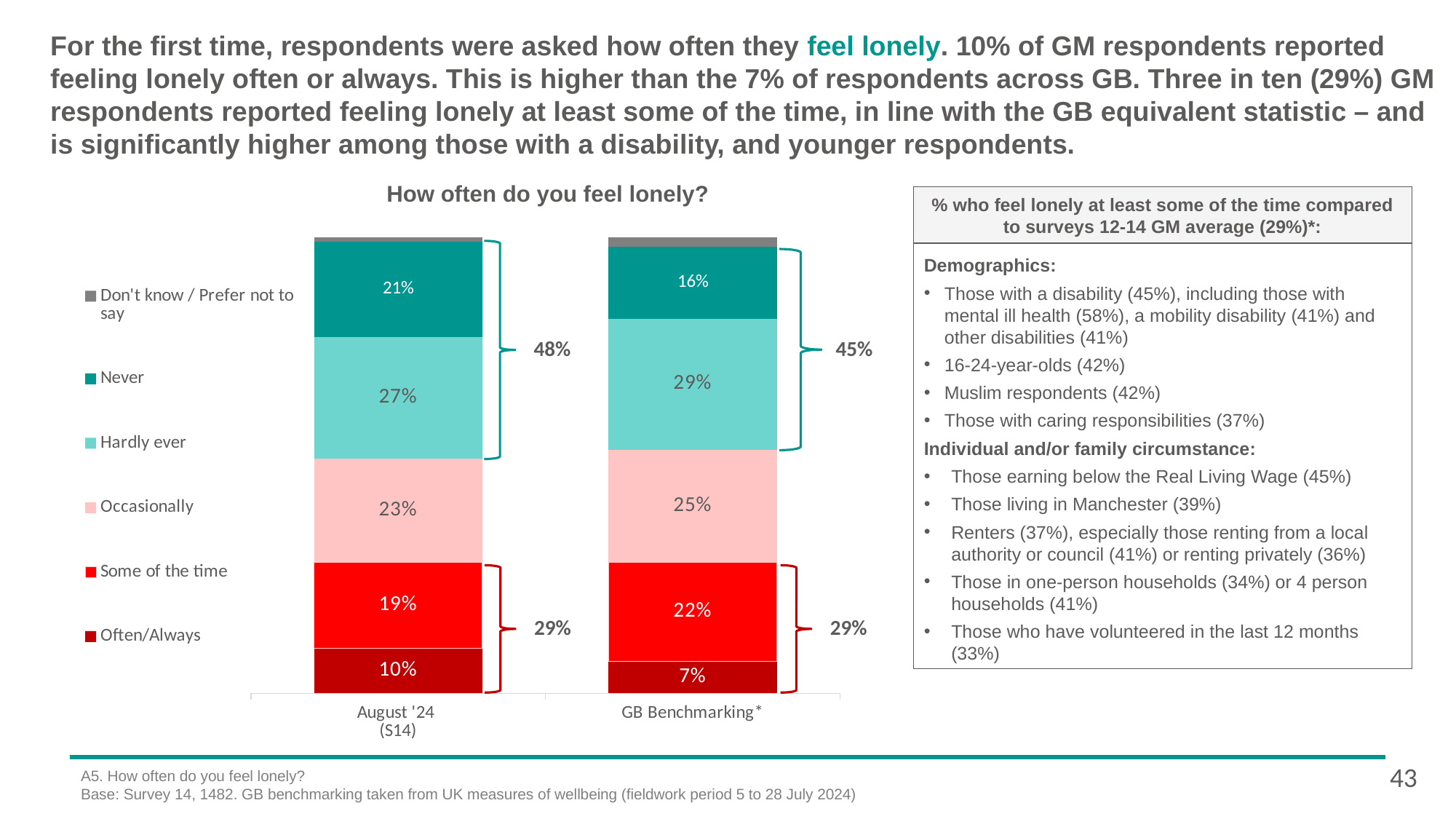
What is the chart's title? How often do you feel lonely? What is the combined percentage of 'Never' and 'Hardly ever' shown by the bracket for the August '24 (S14) bar? 48% What is the value for 'Never' in the August '24 (S14) bar? 21% How many bars (categories) are plotted on the x axis? 2 What is the difference between the 'Often/Always' values for August '24 (S14) and GB Benchmarking? 3 percentage points What percentage of August '24 (S14) respondents said they feel lonely Often/Always? 10% What type of chart is shown on the slide? Stacked bar chart Which bar has the larger 'Occasionally' value, August '24 (S14) or GB Benchmarking? GB Benchmarking What percentage of GB Benchmarking respondents said they feel lonely Often/Always? 7% What is the value for 'Some of the time' in the GB Benchmarking bar? 22% How many series does the legend list? 6 What is the value for 'Hardly ever' in the GB Benchmarking bar? 29%